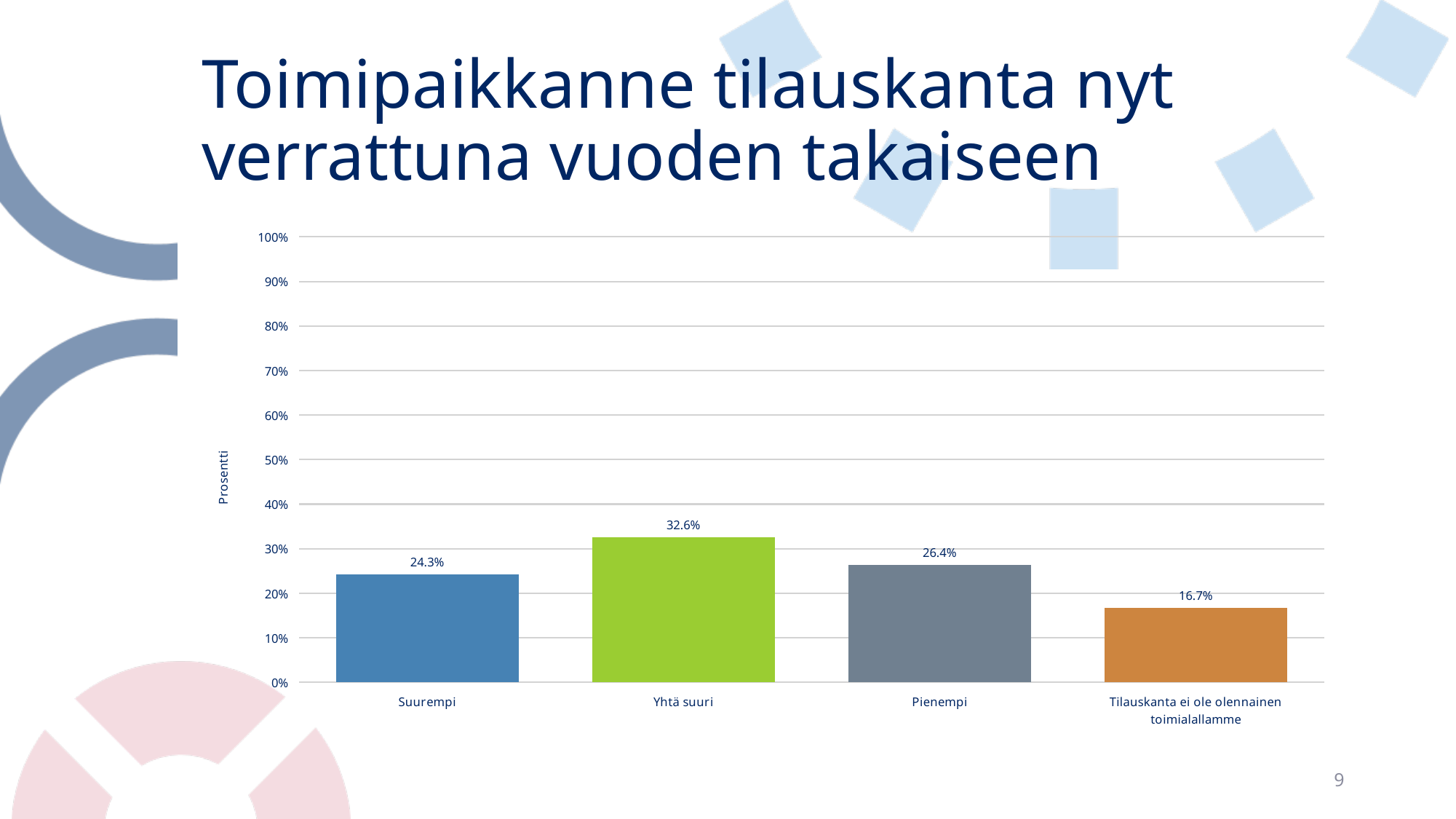
What kind of chart is shown on the slide? Bar chart How many categories are shown on the x axis? 4 Which category has the highest value? Yhtä suuri What is the value for Suurempi? 24.3% What is the value for Tilauskanta ei ole olennainen toimialallamme? 16.7% Which is larger, the value for Pienempi or the value for Suurempi? Pienempi What is the value for Pienempi? 26.4% What is the value for Yhtä suuri? 32.6% What is the label of the vertical axis? Prosentti Is the value for Yhtä suuri greater or less than 30%? greater What is the difference between the values for Yhtä suuri and Suurempi? 8.3% Which category has the lowest value? Tilauskanta ei ole olennainen toimialallamme